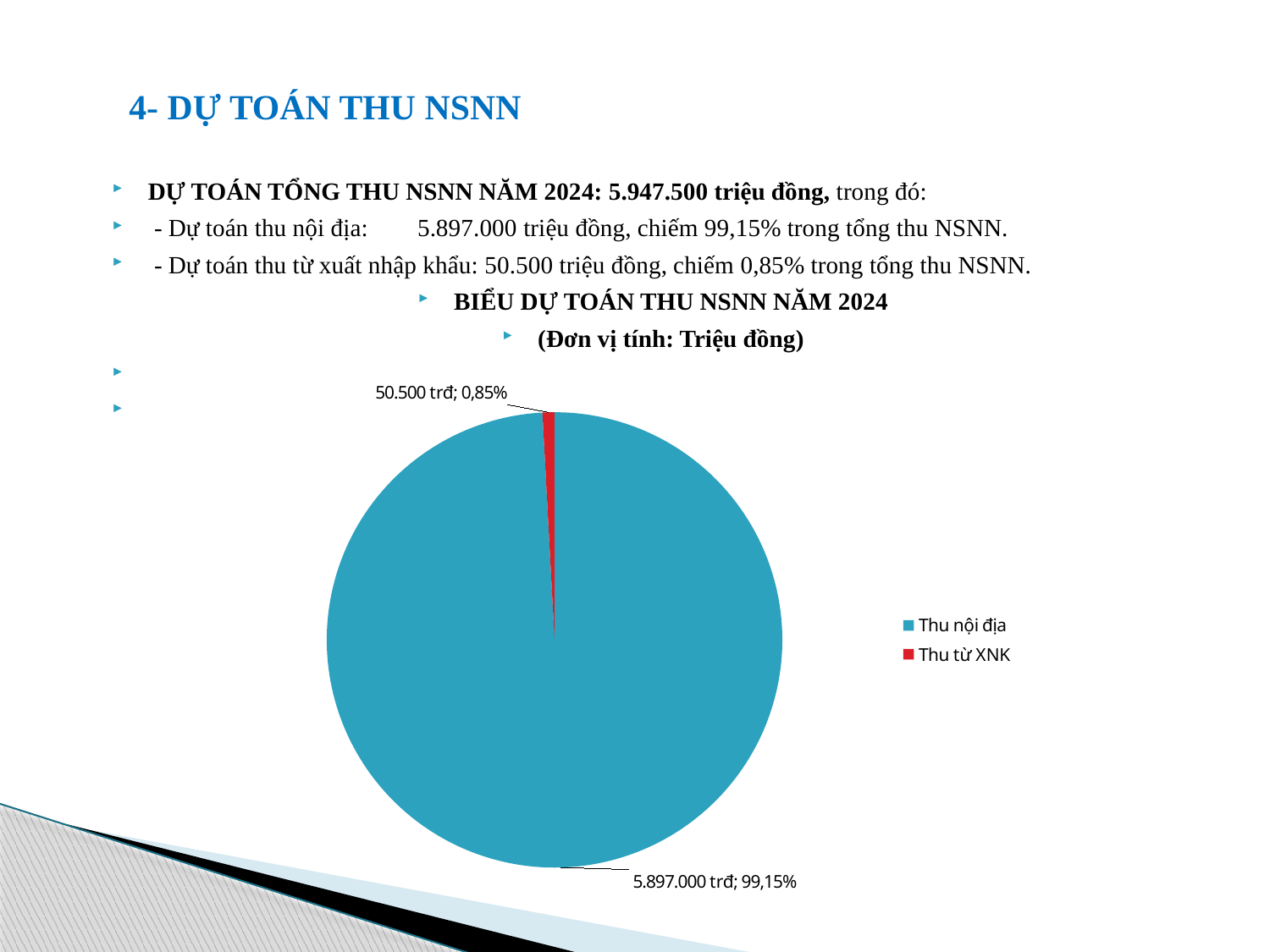
Which slice of the pie chart is the largest? Thu nội địa What kind of chart is shown on the slide? pie chart How many slices does the pie chart have? 2 Which slice of the pie chart is the smallest? Thu từ XNK Which is larger in the pie chart, Thu nội địa or Thu từ XNK? Thu nội địa How many entries does the legend of the pie chart list? 2 What is the value shown for Thu từ XNK in the pie chart? 50.500 trđ What is the difference between the values for Thu nội địa and Thu từ XNK in the pie chart? 5.846.500 trđ What is the value shown for Thu nội địa in the pie chart? 5.897.000 trđ What colour is the Thu từ XNK slice in the pie chart? red What share of the pie does Thu nội địa represent? 99,15% What share of the pie does Thu từ XNK represent? 0,85%